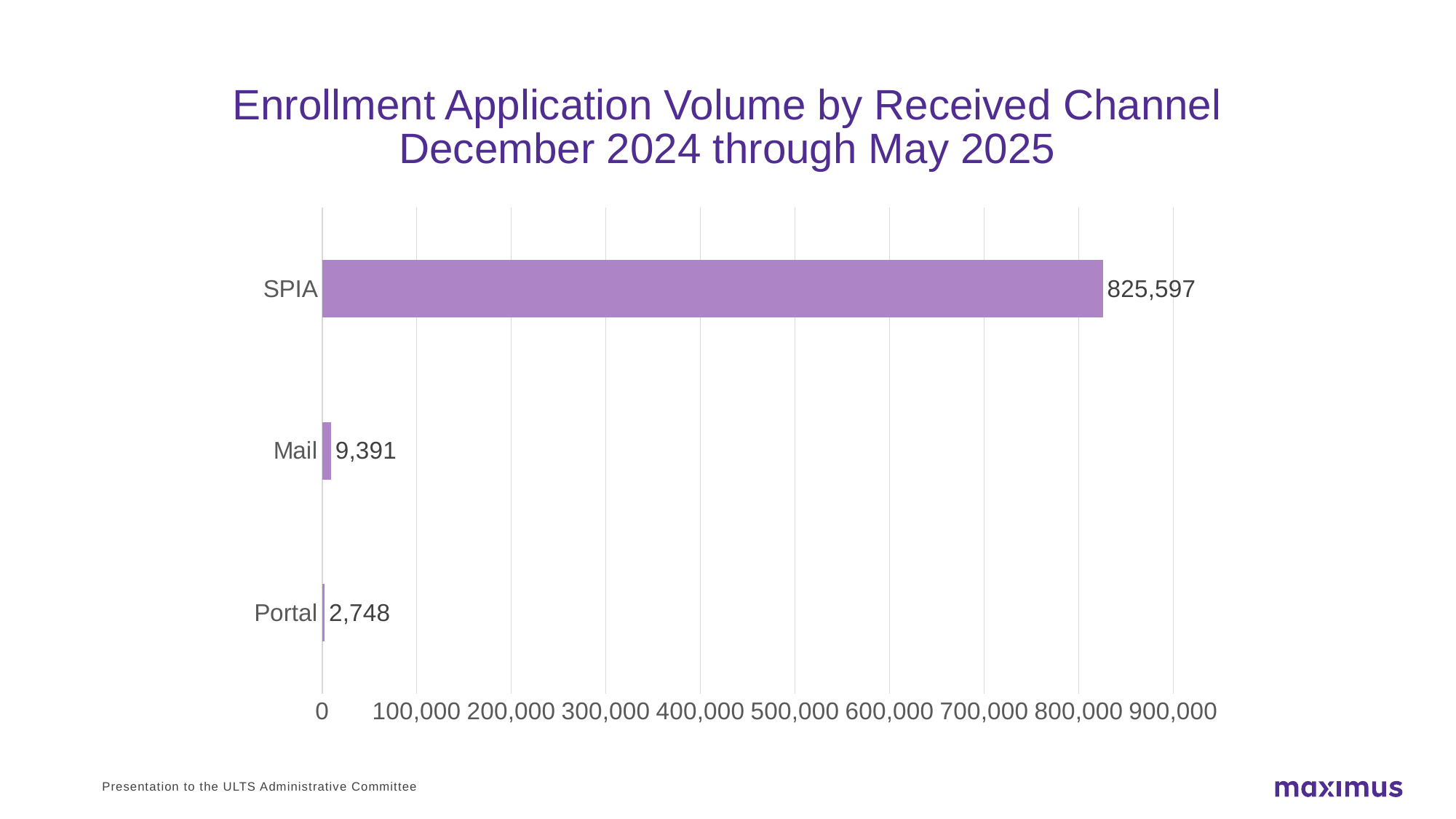
What is the enrollment application volume for SPIA? 825,597 How many received channels are shown in the chart? 3 What is the title of the chart? Enrollment Application Volume by Received Channel December 2024 through May 2025 Which received channel has the highest application volume? SPIA What is the difference between the Mail and Portal application volumes? 6,643 What kind of chart is shown on the slide? Bar chart What is the enrollment application volume for Portal? 2,748 What is the difference between the SPIA and Mail application volumes? 816,206 What is the enrollment application volume for Mail? 9,391 Which has a larger application volume, Mail or Portal? Mail Which received channel has the lowest application volume? Portal Is the value for SPIA greater or less than 800,000? greater